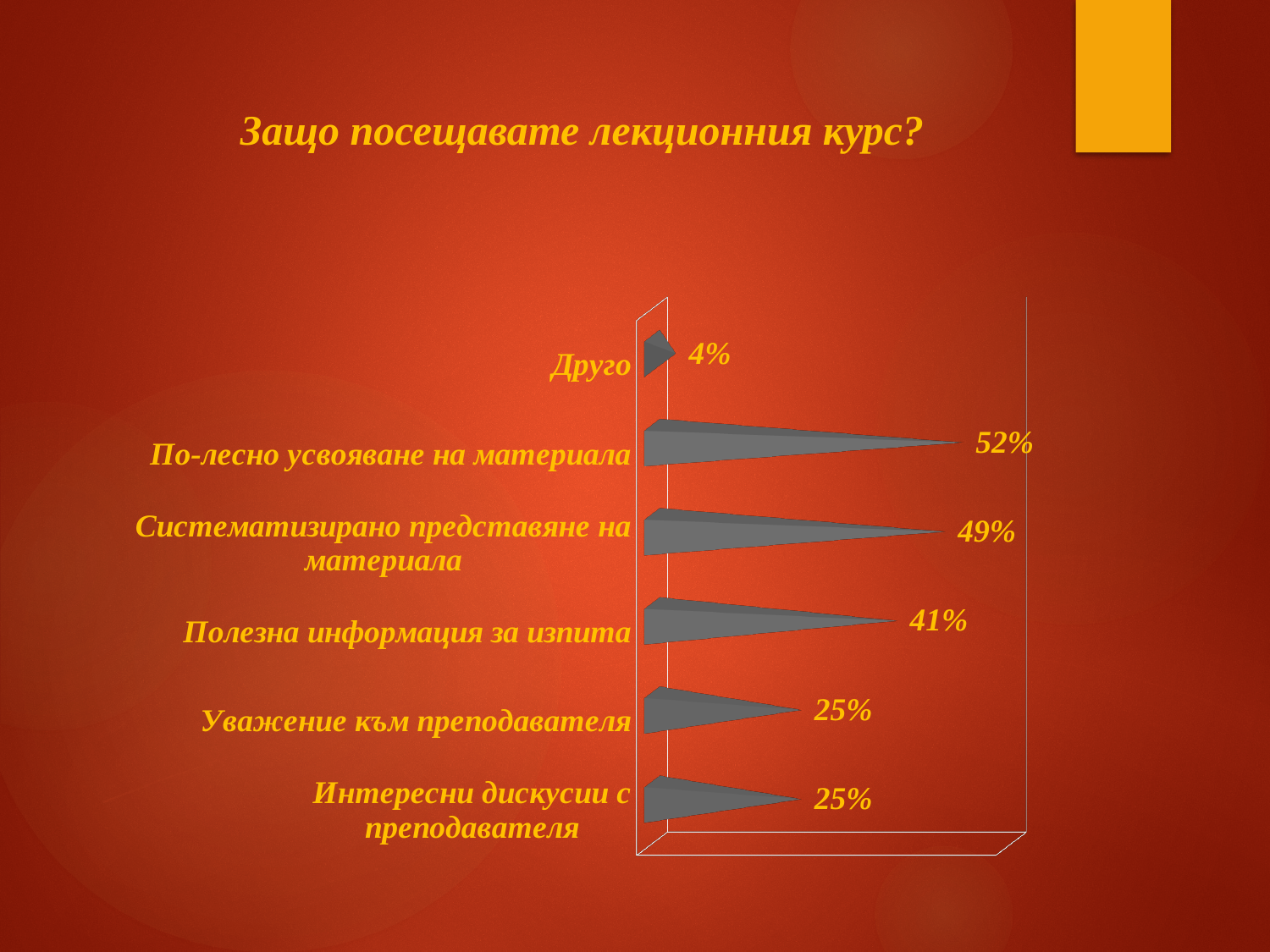
Which category has the highest value? По-лесно усвояване на материала What is the value for "Полезна информация за изпита"? 41% What kind of chart is shown on the slide? Bar chart Which is larger: the value for "Систематизирано представяне на материала" or the value for "Уважение към преподавателя"? Систематизирано представяне на материала Which category has the lowest value? Друго What is the difference between the values for "По-лесно усвояване на материала" and "Полезна информация за изпита"? 11% What is the title of the slide? Защо посещавате лекционния курс? How many categories are shown in the chart? 6 What is the difference between the values for "Полезна информация за изпита" and "Интересни дискусии с преподавателя"? 16% What is the value for "По-лесно усвояване на материала"? 52% What is the value for "Систематизирано представяне на материала"? 49% What is the value for "Друго"? 4%